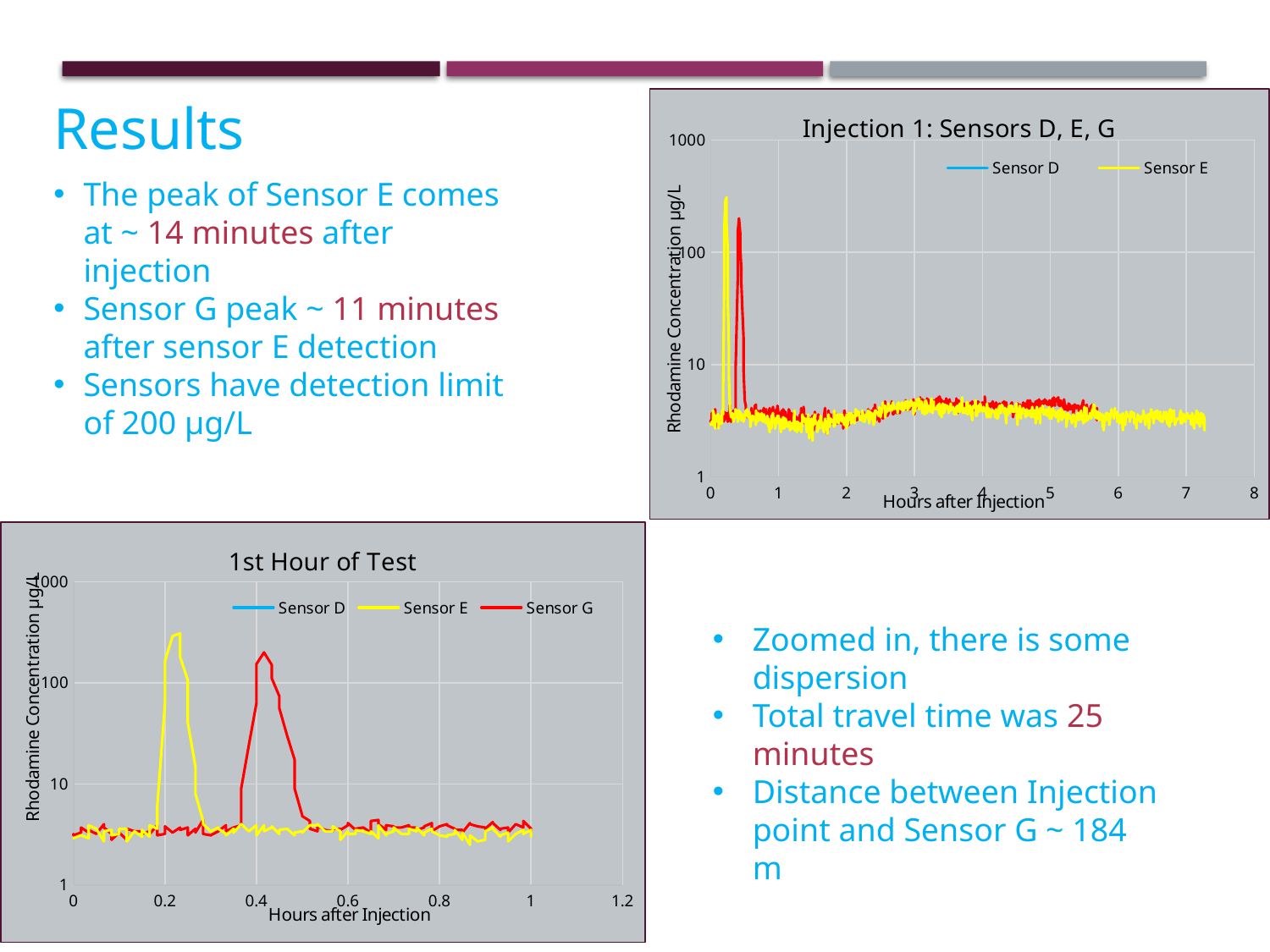
What is the y-axis label of the "1st Hour of Test" chart? Rhodamine Concentration µg/L What is the x-axis label of the "Injection 1: Sensors D, E, G" chart? Hours after Injection In the "1st Hour of Test" chart, is the peak value of Sensor E greater or less than 100? greater In the "1st Hour of Test" chart, is the baseline value of Sensor E at 0.8 hours greater or less than 10? less In the "1st Hour of Test" chart, which series reaches its peak first along the x axis, Sensor E or Sensor G? Sensor E In the "1st Hour of Test" chart, is the peak value of Sensor G greater or less than 100? greater In the "1st Hour of Test" chart, which series has the higher peak, Sensor E or Sensor G? Sensor E What kind of chart is the "1st Hour of Test" chart? line chart How many series does the legend of the "Injection 1: Sensors D, E, G" chart list? 2 What kind of chart is the "Injection 1: Sensors D, E, G" chart? line chart How many series does the legend of the "1st Hour of Test" chart list? 3